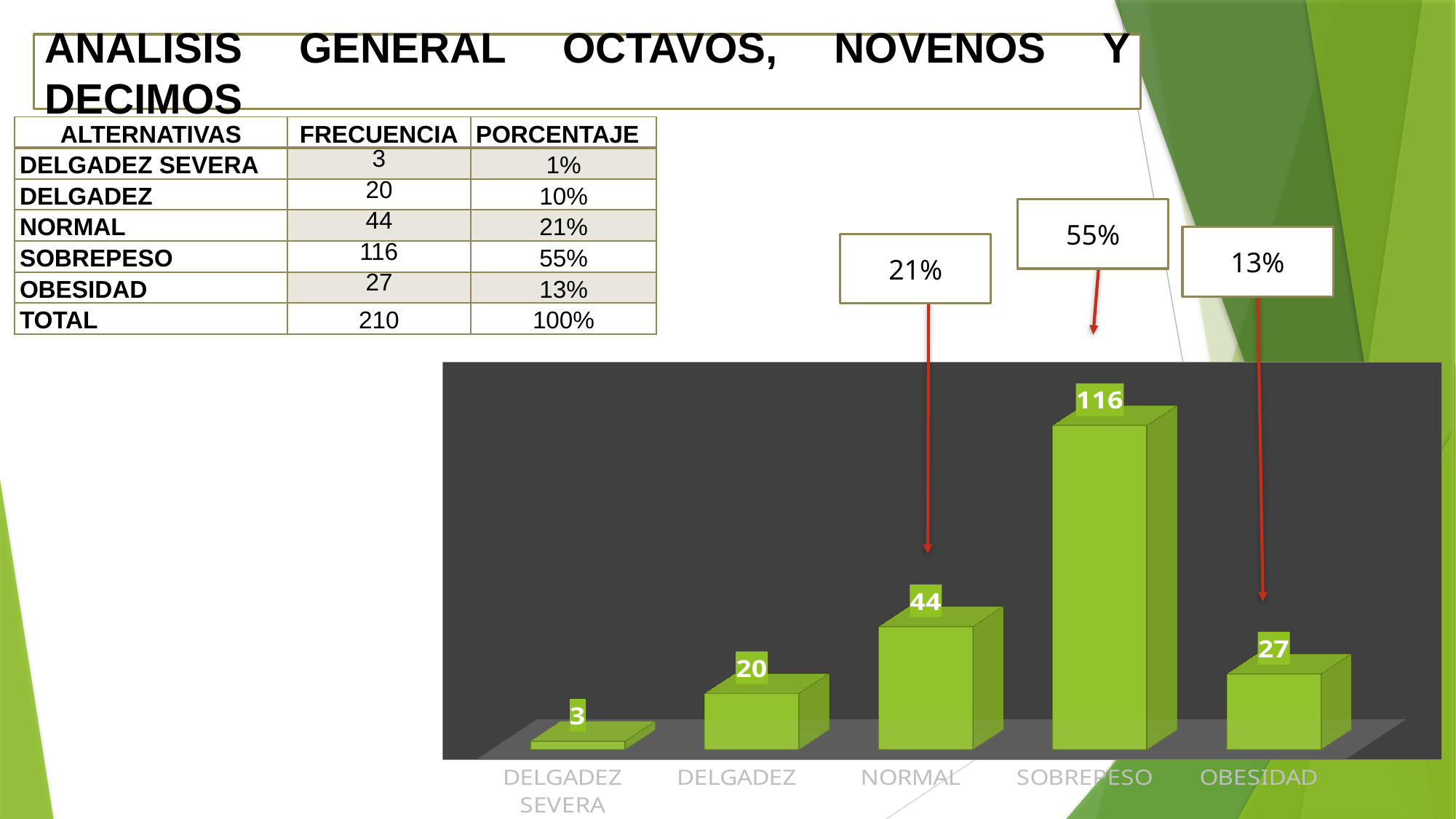
What is the value for SOBREPESO in the bar chart? 116 What kind of chart is shown on the slide? bar chart Which is larger in the bar chart, the value for NORMAL or the value for OBESIDAD? NORMAL Which category has the lowest value in the bar chart? DELGADEZ SEVERA What is the difference between the values for SOBREPESO and NORMAL in the bar chart? 72 What is the value for OBESIDAD in the bar chart? 27 What is the value for DELGADEZ SEVERA in the bar chart? 3 How many categories are shown in the bar chart? 5 What is the value for NORMAL in the bar chart? 44 What percentage does the callout box above the SOBREPESO bar show? 55% Which category has the highest value in the bar chart? SOBREPESO What is the difference between the values for OBESIDAD and DELGADEZ in the bar chart? 7